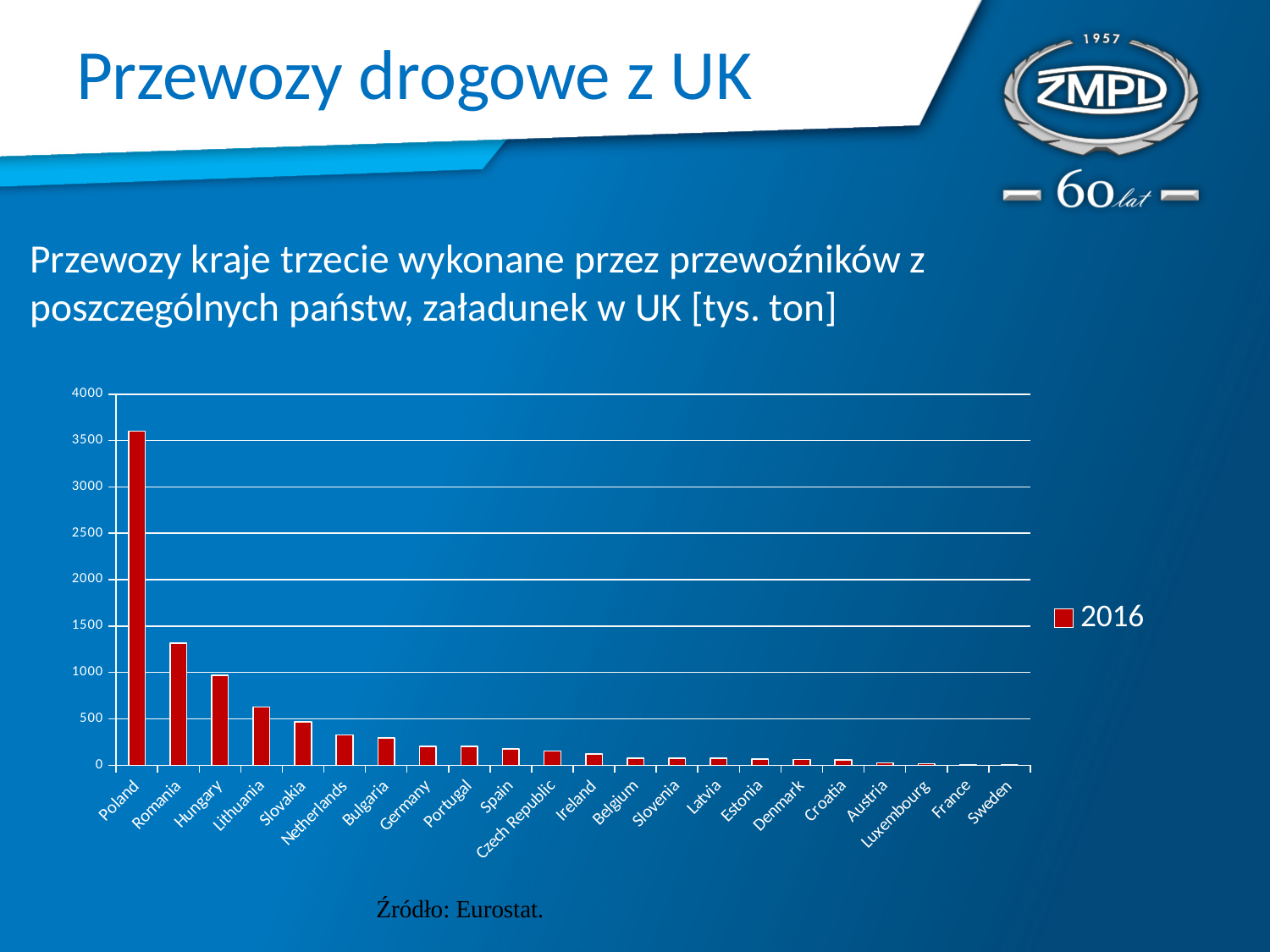
Which is larger, the value for Romania or the value for Hungary? Romania How many series does the legend list? 1 What kind of chart is shown on the slide? bar chart Is the value for Poland greater or less than 3500? greater Is the value for Lithuania greater or less than 500? greater What colour are the bars in the chart? red How many countries are shown on the x axis of the chart? 22 What is the legend entry for the series shown in the chart? 2016 Do the values rise or fall moving from left to right along the x axis? fall Is the value for Romania greater or less than 1500? less Which country has the highest value in the chart? Poland